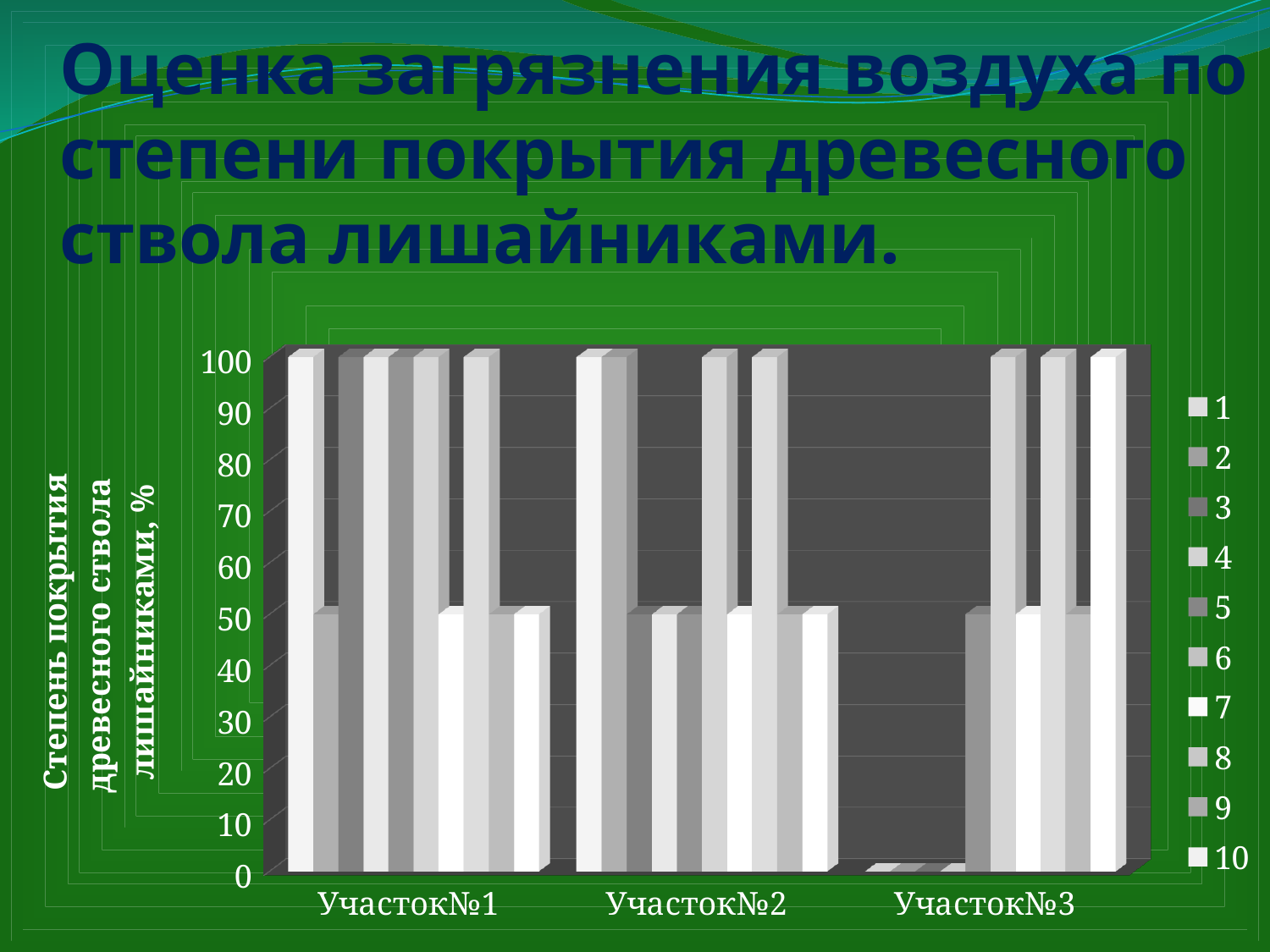
Which is larger for Участок№1: the value of series 1 or the value of series 2? series 1 For series 1, which category has the larger value: Участок№1 or Участок№3? Участок№1 What is the title of the vertical axis? Степень покрытия древесного ствола лишайниками, % What kind of chart is shown on the slide? bar chart Is the value of series 1 for Участок№1 greater or less than 90? greater Is the value of series 2 for Участок№1 greater or less than 70? less How many categories (участки) are shown on the x axis? 3 How many series does the legend list? 10 Is the value of series 10 for Участок№3 greater or less than 90? greater What is the highest tick value shown on the vertical axis? 100